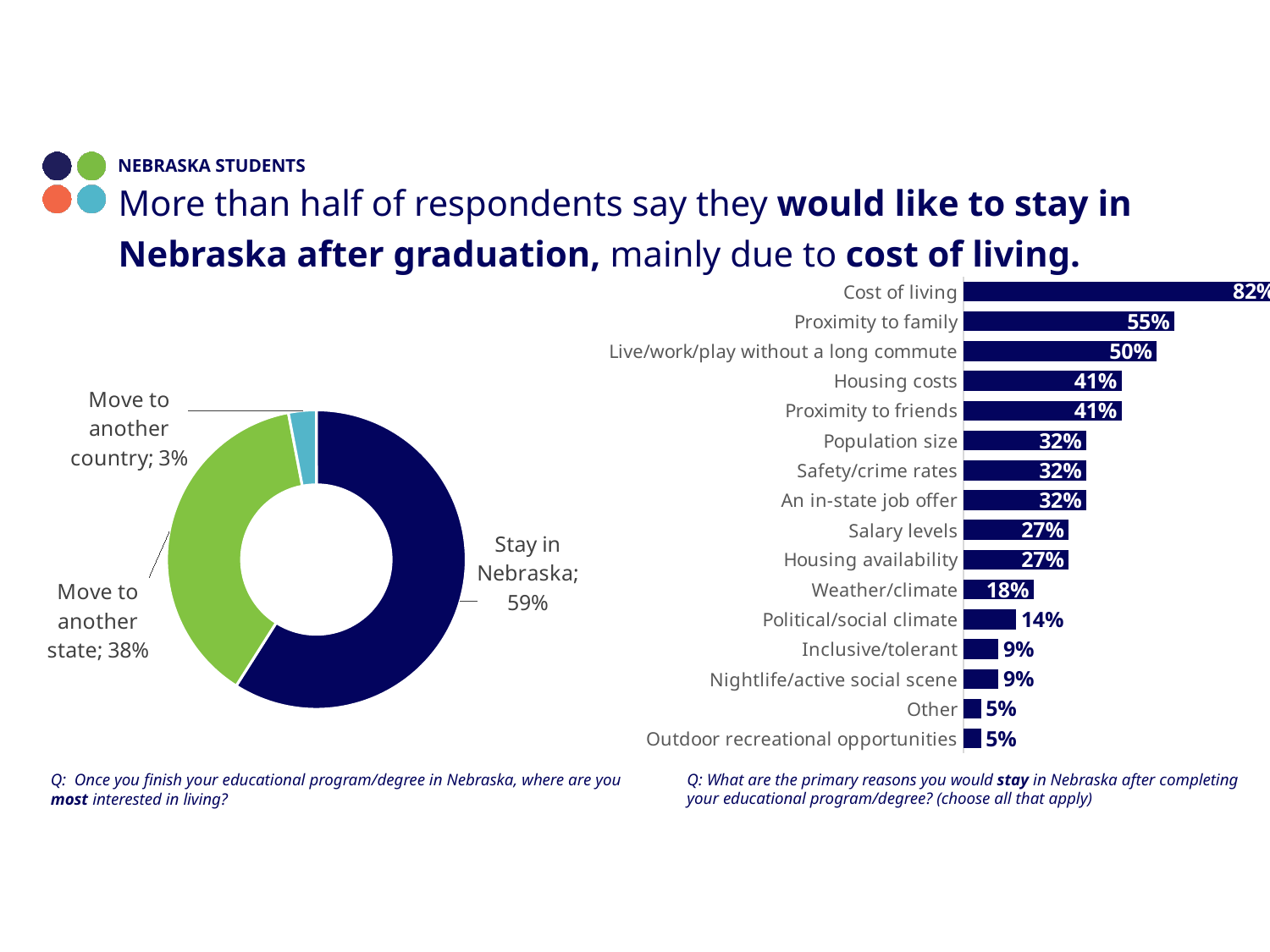
In the bar chart on the right, how many reasons are listed? 16 In the bar chart on the right, what is the value for Cost of living? 82% In the bar chart on the right, which is larger: Housing costs or Population size? Housing costs What type of chart is shown on the right side of the slide? Bar chart In the bar chart on the right, what is the difference between Proximity to family and Live/work/play without a long commute? 5% In the donut chart on the left, what share of respondents say they want to stay in Nebraska? 59% In the bar chart on the right, which reason has the highest value? Cost of living In the bar chart on the right, what is the value for Political/social climate? 14% In the donut chart on the left, what percentage of respondents want to move to another country? 3% In the bar chart on the right, what is the value for Weather/climate? 18% In the donut chart on the left, what is the difference between the share who want to stay in Nebraska and the share who want to move to another state? 21% In the donut chart on the left, how many slices are shown? 3